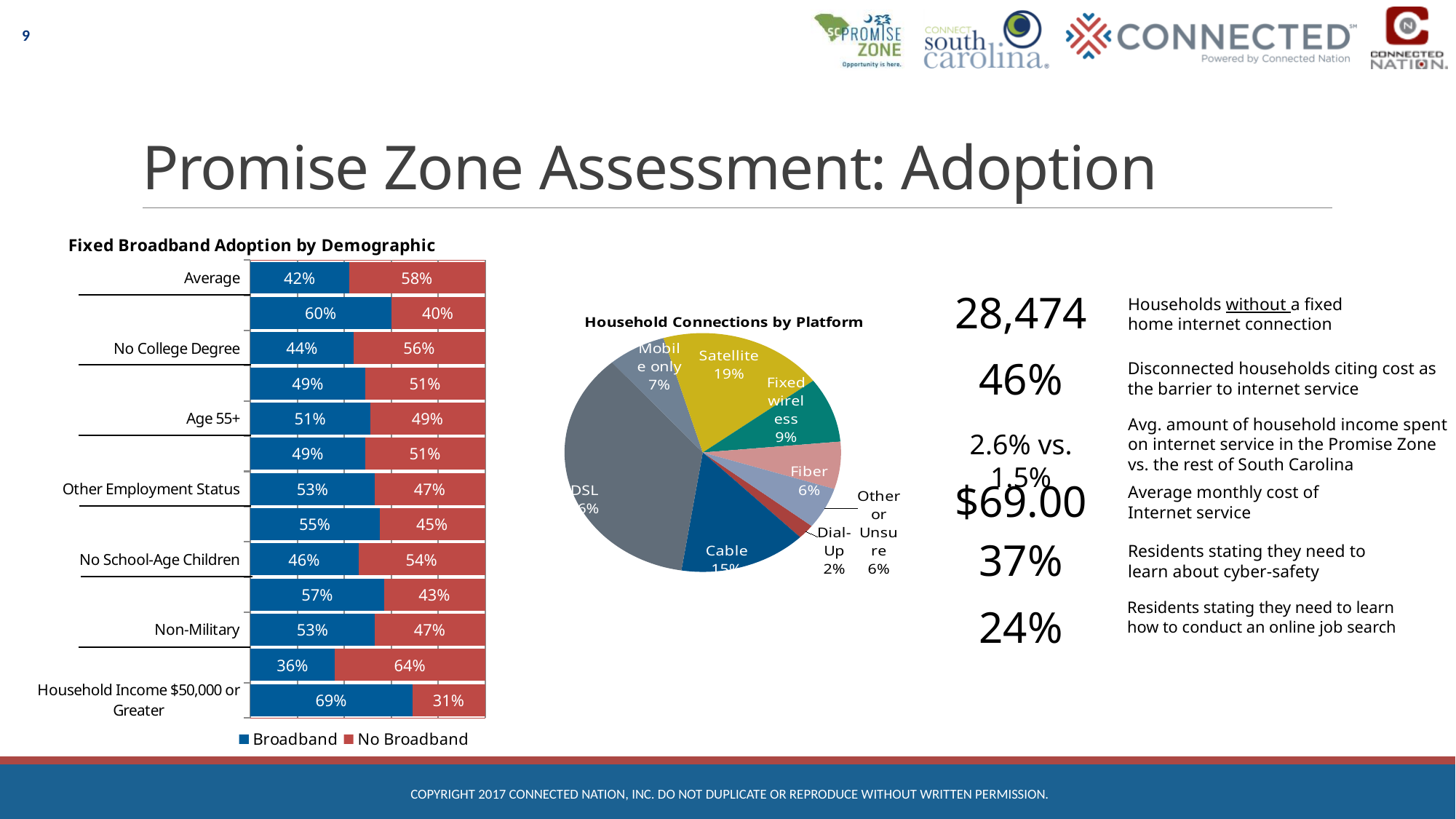
In the Fixed Broadband Adoption by Demographic chart, which labeled category has the highest Broadband value? Household Income $50,000 or Greater In the Fixed Broadband Adoption by Demographic chart, what is the Broadband value for Non-Military? 53% In the Fixed Broadband Adoption by Demographic chart, what is the No Broadband value for Household Income $50,000 or Greater? 31% In the Fixed Broadband Adoption by Demographic chart, what is the Broadband value for Average? 42% In the Fixed Broadband Adoption by Demographic chart, what is the difference between the No Broadband and Broadband values for Average? 16 percentage points In the Household Connections by Platform pie chart, what share is Dial-Up? 2% In the Household Connections by Platform pie chart, what share is Fixed wireless? 9% In the Household Connections by Platform pie chart, which is larger, Satellite or Mobile only? Satellite What kind of chart is the Fixed Broadband Adoption by Demographic chart? Stacked bar chart How many series does the legend of the Fixed Broadband Adoption by Demographic chart list? 2 In the Household Connections by Platform pie chart, what share is Satellite? 19% In the Fixed Broadband Adoption by Demographic chart, what is the Broadband value for No College Degree? 44%